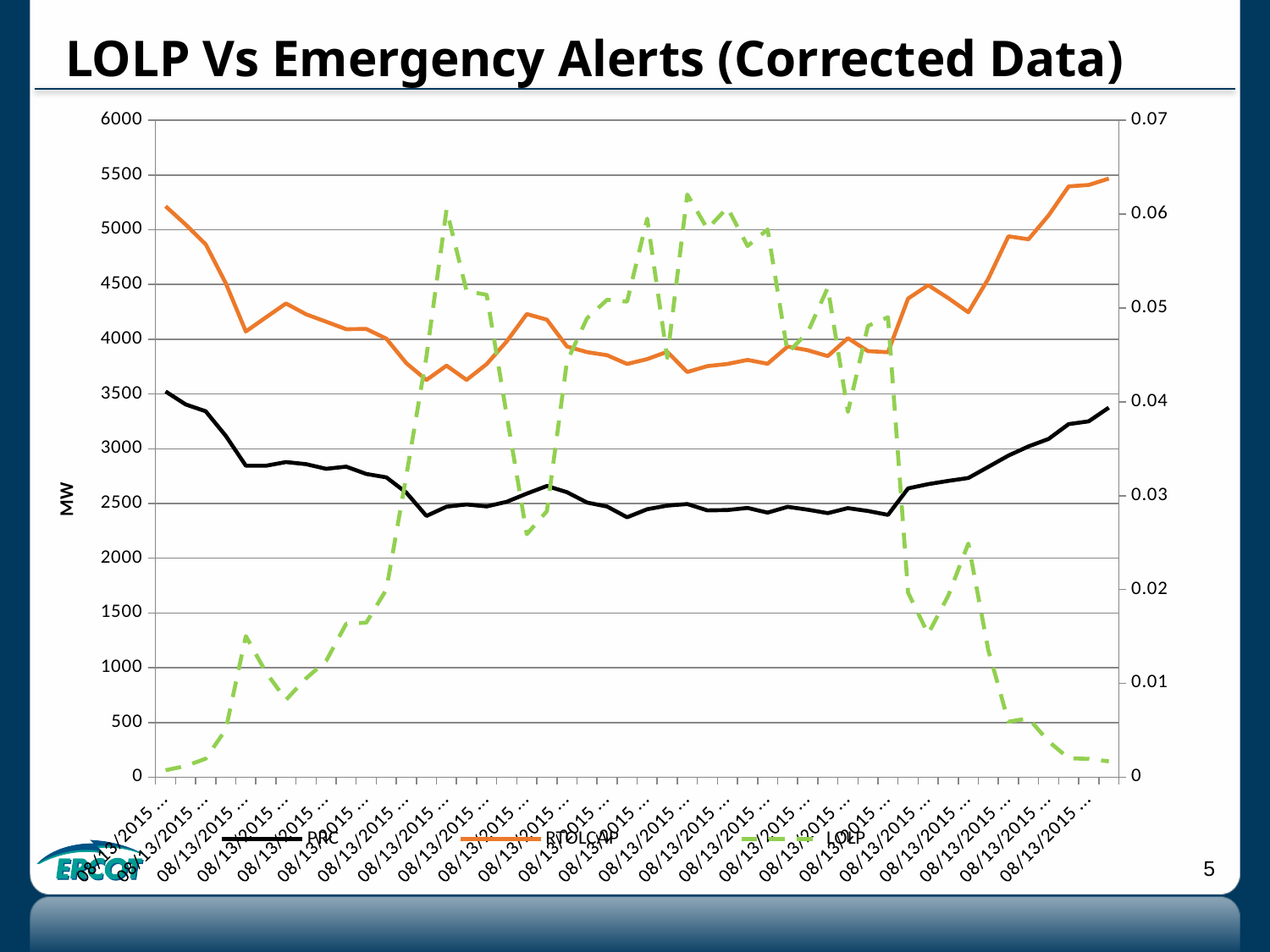
Is the last plotted value of PRC greater or less than 3000? greater Does the LOLP line rise or fall over the last several points at the right end of the chart? fall Which series is plotted higher on the chart throughout, PRC or RTOLCAP? RTOLCAP Is the lowest value reached by the PRC line greater or less than 2000? greater Is the first plotted value of RTOLCAP greater or less than 5000? greater What kind of chart is shown on the slide? line chart What is the title of the chart? LOLP Vs Emergency Alerts (Corrected Data) Which series is drawn with a dashed line? LOLP How many series does the legend list? 3